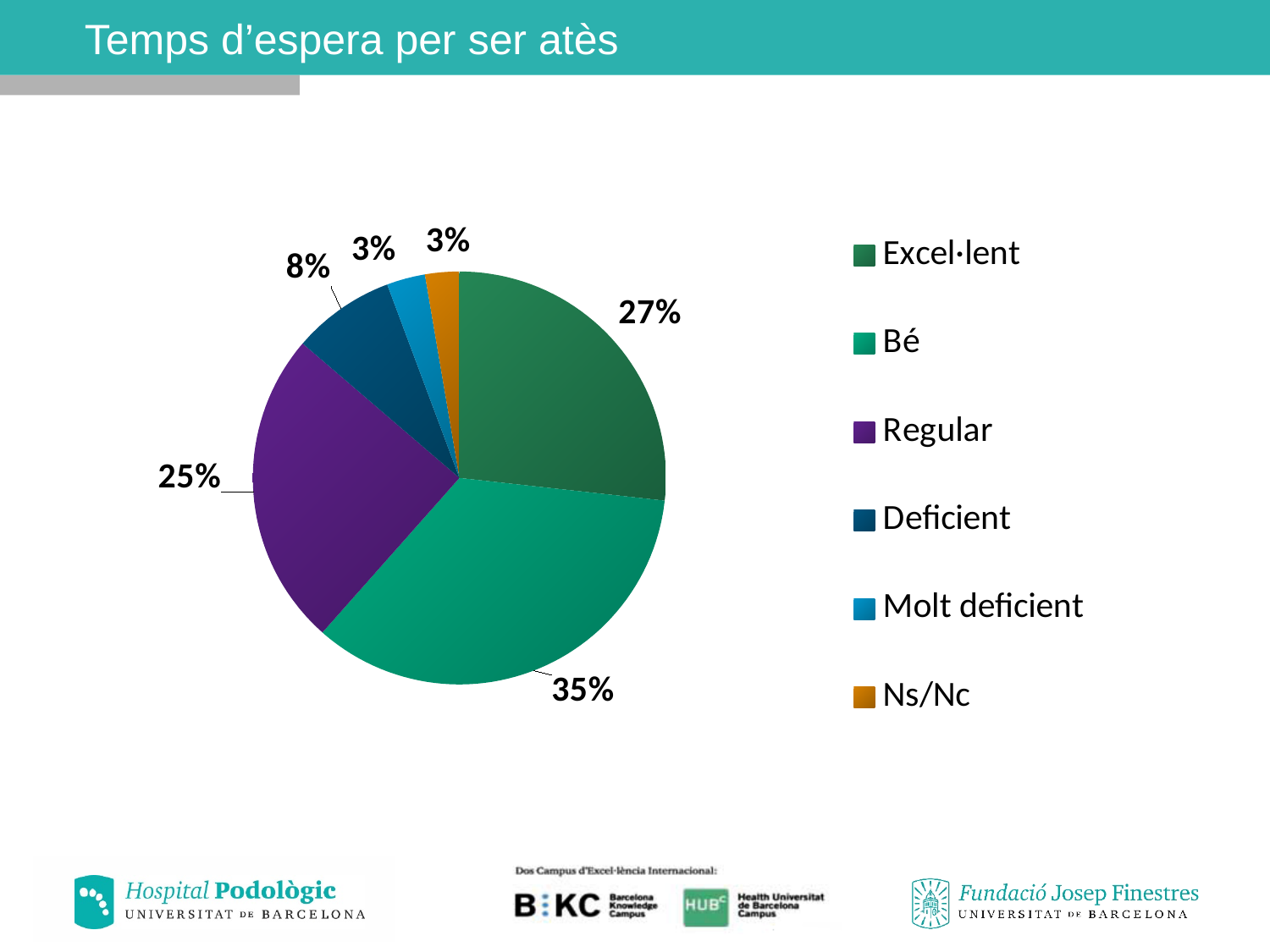
What percentage of the pie corresponds to Deficient? 8% What kind of chart is shown on the slide? pie chart What is the difference in percentage points between Bé and Excel·lent? 8 How many categories does the legend list? 6 Which slice is larger, Regular or Deficient? Regular What percentage of the pie corresponds to Bé? 35% What percentage of the pie corresponds to Regular? 25% Which category has the largest slice of the pie? Bé What percentage of the pie corresponds to Excel·lent? 27% What percentage of the pie corresponds to Molt deficient? 3% What is the combined share of Excel·lent and Bé? 62% What is the title of the chart on the slide? Temps d'espera per ser atès